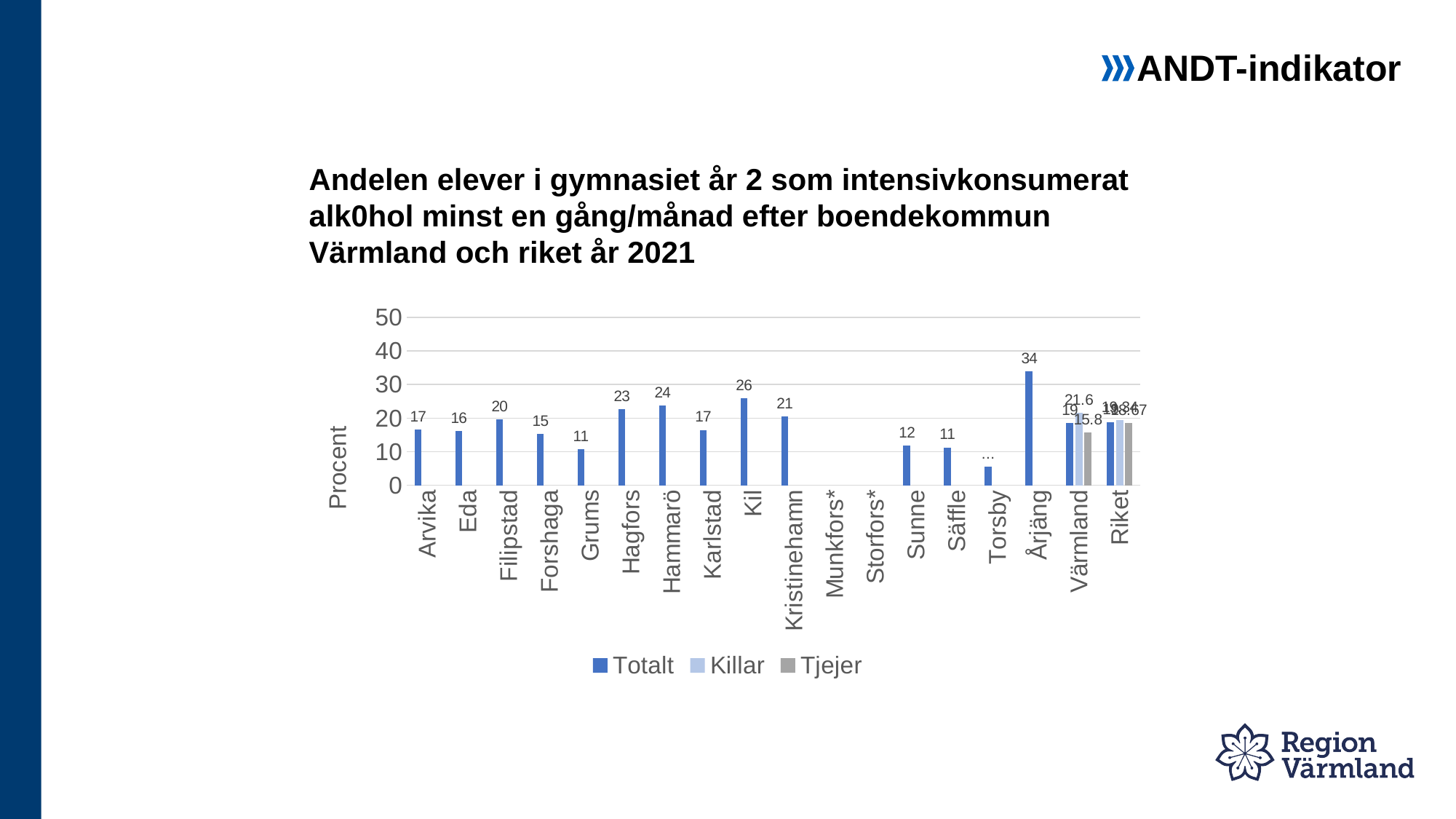
What is the difference between the Killar and Tjejer values for Värmland? 5.8 Which municipality has the highest value? Årjäng Which is larger, the value for Hammarö or the value for Hagfors? Hammarö What is the Killar value for Värmland? 21.6 Is the value for Torsby greater or less than 10? less What is the difference between the values for Årjäng and Kil? 8 What kind of chart is shown? bar chart How many series does the legend list? 3 What is the value for Kil? 26 What is the label on the vertical axis? Procent What is the value for Årjäng? 34 What is the Tjejer value for Värmland? 15.8